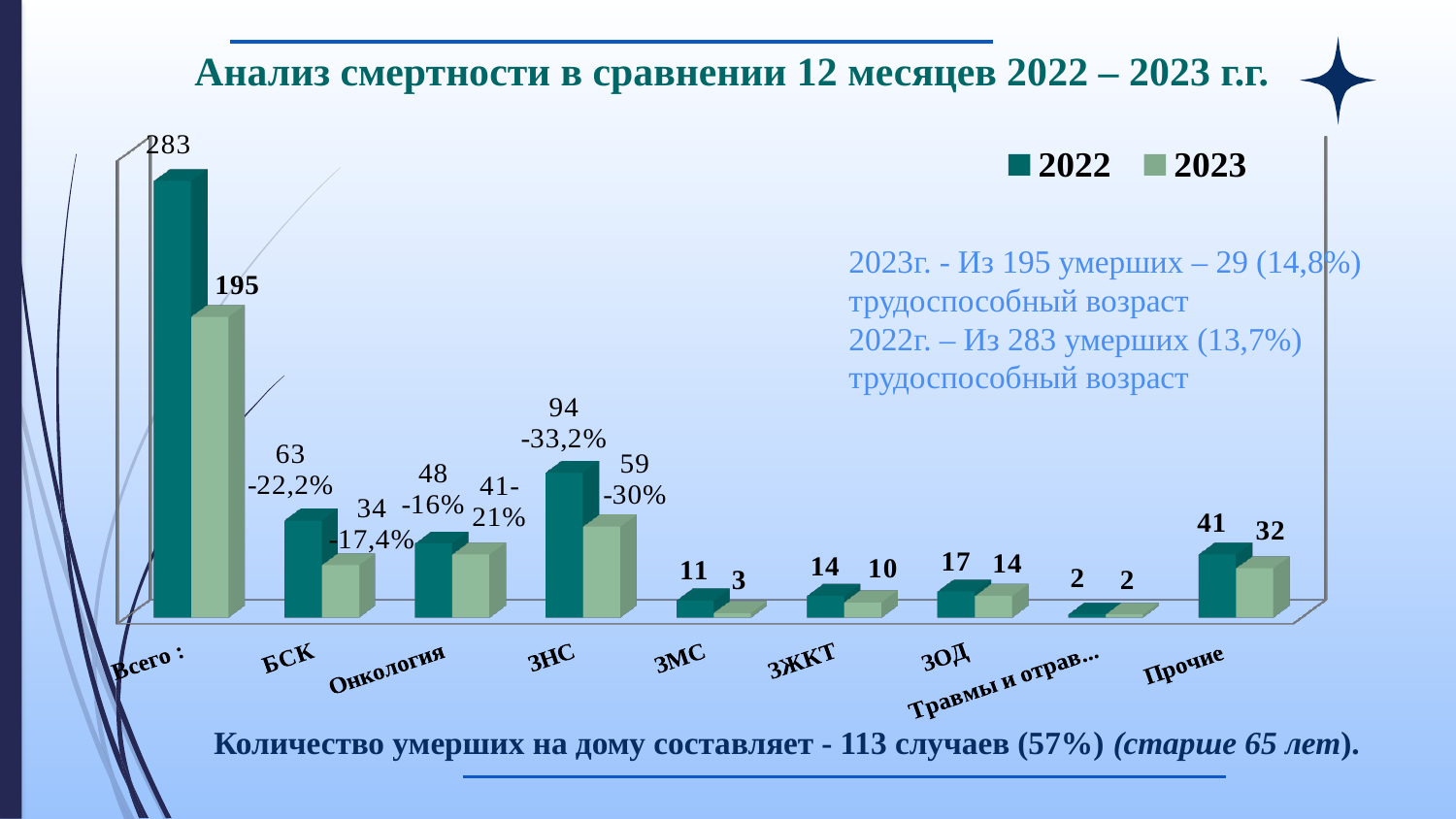
What is the value for 2022 in the Всего category? 283 What is the value for 2022 in the ЗМС category? 11 Which category has the lowest 2023 value? Травмы и отрав... Which is larger: the 2022 value for ЗОД or the 2022 value for ЗЖКТ? ЗОД What is the difference between the 2022 and 2023 values in the Всего category? 88 What is the value for 2023 in the Всего category? 195 What is the value for 2023 in the Прочие category? 32 What kind of chart is shown on the slide? Bar chart What is the difference between the 2022 and 2023 values in the ЗНС category? 35 Excluding the Всего total, which category has the highest 2022 value? ЗНС What is the value for 2023 in the ЗНС category? 59 How many series does the legend list? 2